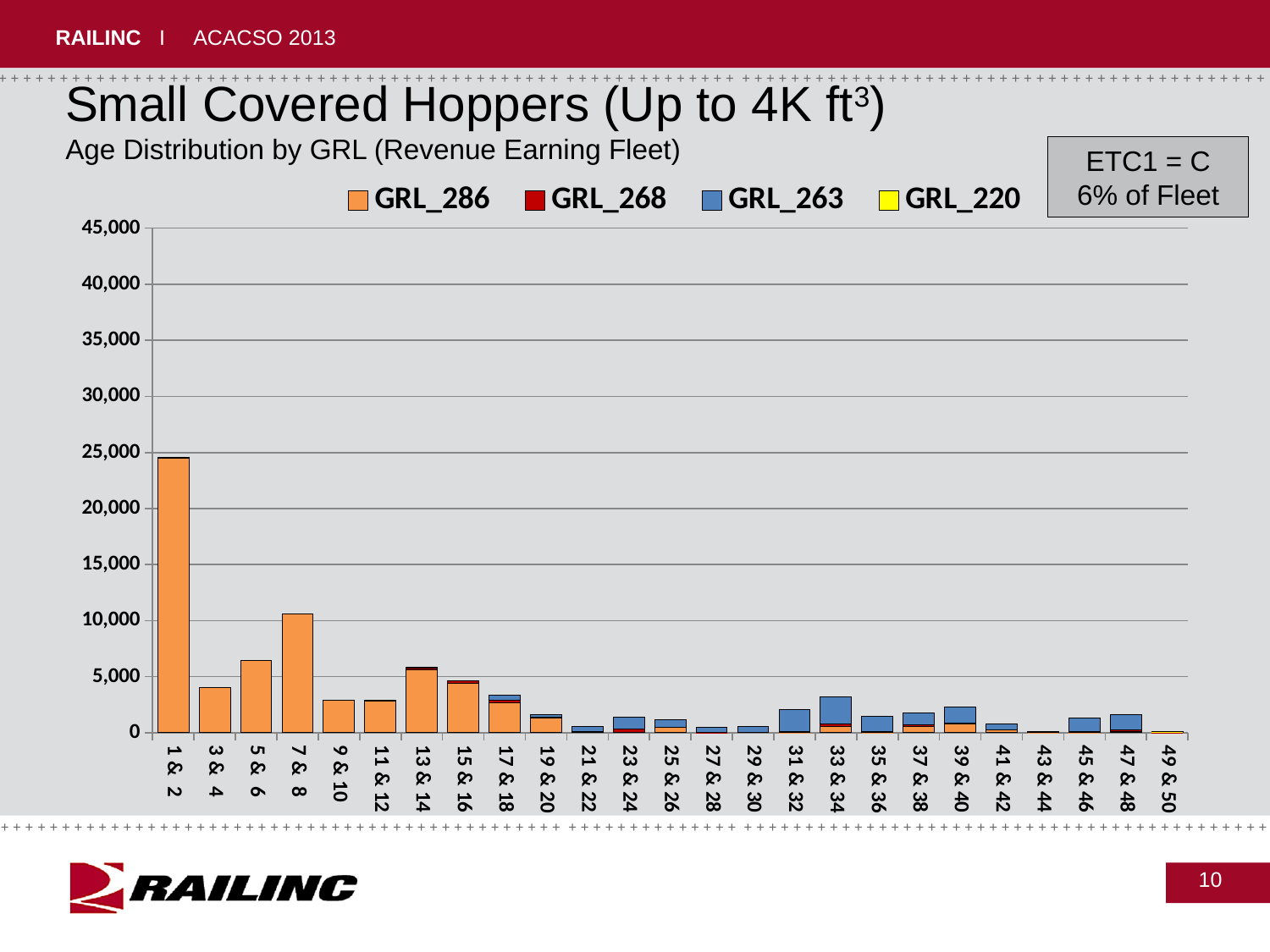
Is the total for the 1 & 2 age group greater or less than 20,000? greater Which age group has the tallest bar? 1 & 2 How many series does the legend list? 4 Is the total for the 9 & 10 age group greater or less than 5,000? less How many age-group categories are shown along the x axis? 25 Do the bar totals generally rise or fall moving from the youngest age group to the oldest along the x axis? fall Which series is shown in orange in the legend? GRL_286 Which bar is taller, 5 & 6 or 3 & 4? 5 & 6 Is the total for the 3 & 4 age group greater or less than 5,000? less What kind of chart is shown on the slide? bar chart Which bar is taller, 1 & 2 or 7 & 8? 1 & 2